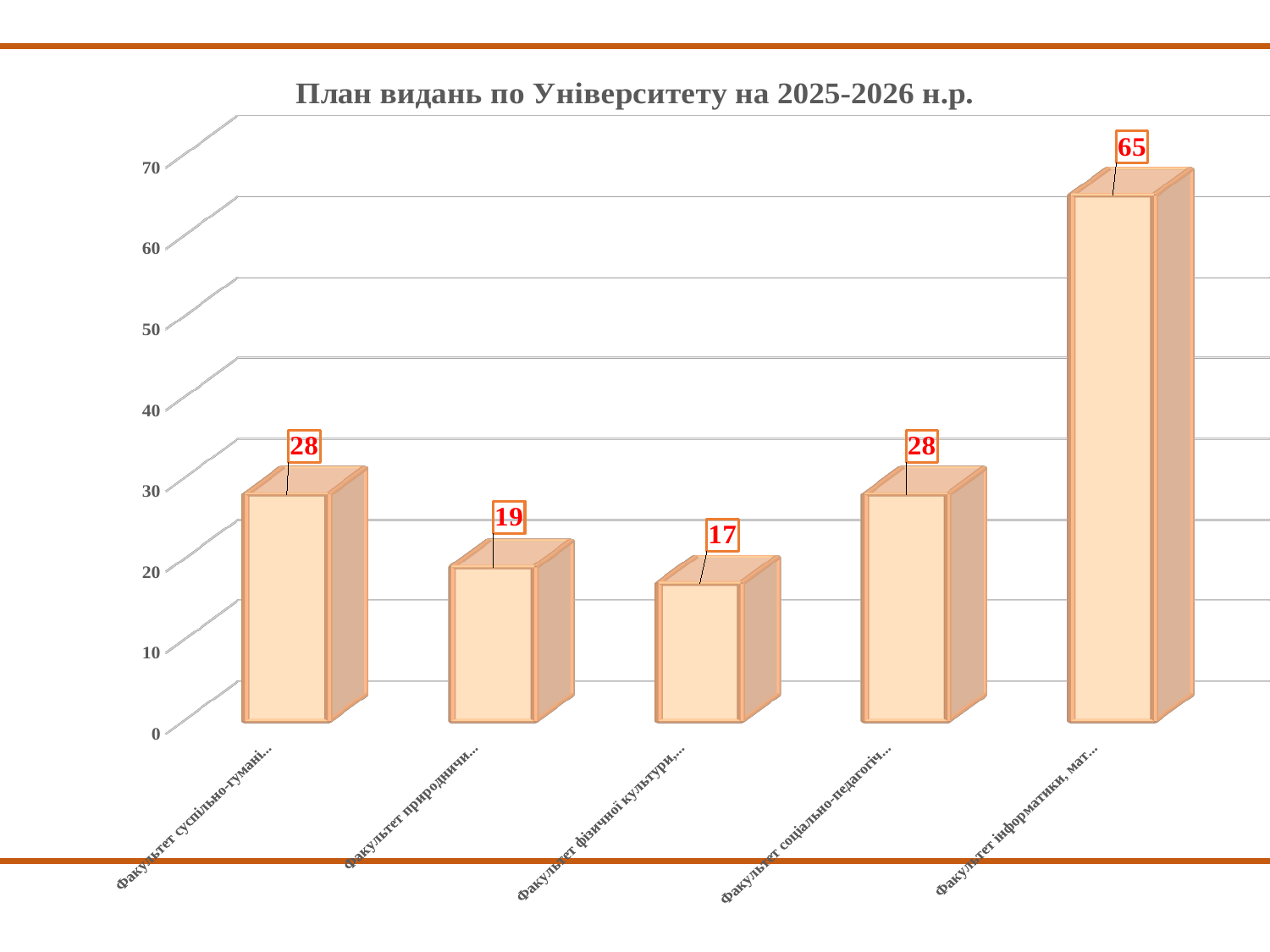
What is the title of the chart? План видань по Університету на 2025-2026 н.р. What is the value for Факультет природничи...? 19 Which category has the highest value? Факультет інформатики, мат... Which category has the lowest value? Факультет фізичної культури,... How many categories are shown in the chart? 5 What is the difference between the values for Факультет природничи... and Факультет фізичної культури,...? 2 Is the value for Факультет інформатики, мат... greater or less than 60? greater What is the value for Факультет фізичної культури,...? 17 What is the value for Факультет інформатики, мат...? 65 Which is larger, the value for Факультет соціально-педагогіч... or the value for Факультет природничи...? Факультет соціально-педагогіч... What kind of chart is shown on the slide? bar chart What is the difference between the values for Факультет інформатики, мат... and Факультет суспільно-гумані...? 37